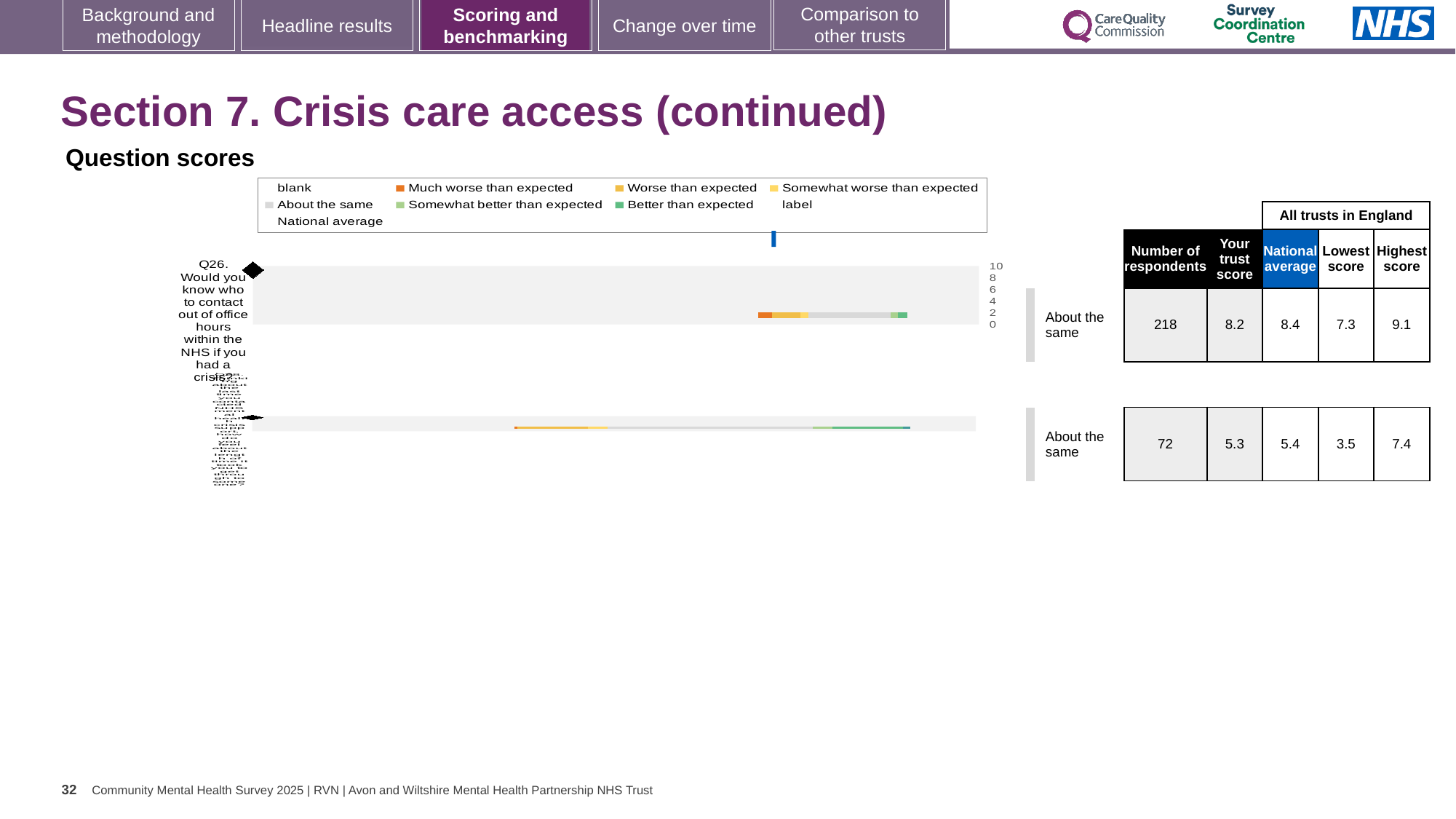
What is the highest value shown on the chart's score axis? 10 In the table beside the chart, what is the lowest score among all trusts in England for Q26? 7.3 In the table beside the chart, what is 'Your trust score' for Q26 (Would you know who to contact out of office hours within the NHS if you had a crisis?)? 8.2 In the table beside the chart, how many respondents answered Q26? 218 What benchmark category is shown next to the chart for Q26? About the same What colour does the legend use for 'Much worse than expected'? orange For Q26, what is the difference between the highest score and the lowest score among all trusts in England? 1.8 What kind of chart is shown under 'Question scores'? bar chart How many question rows are plotted in the chart? 2 In the table beside the chart, what is the highest score among all trusts in England for Q26? 9.1 For Q26, which is larger: the trust score or the national average? national average In the table beside the chart, what is the national average for Q26? 8.4